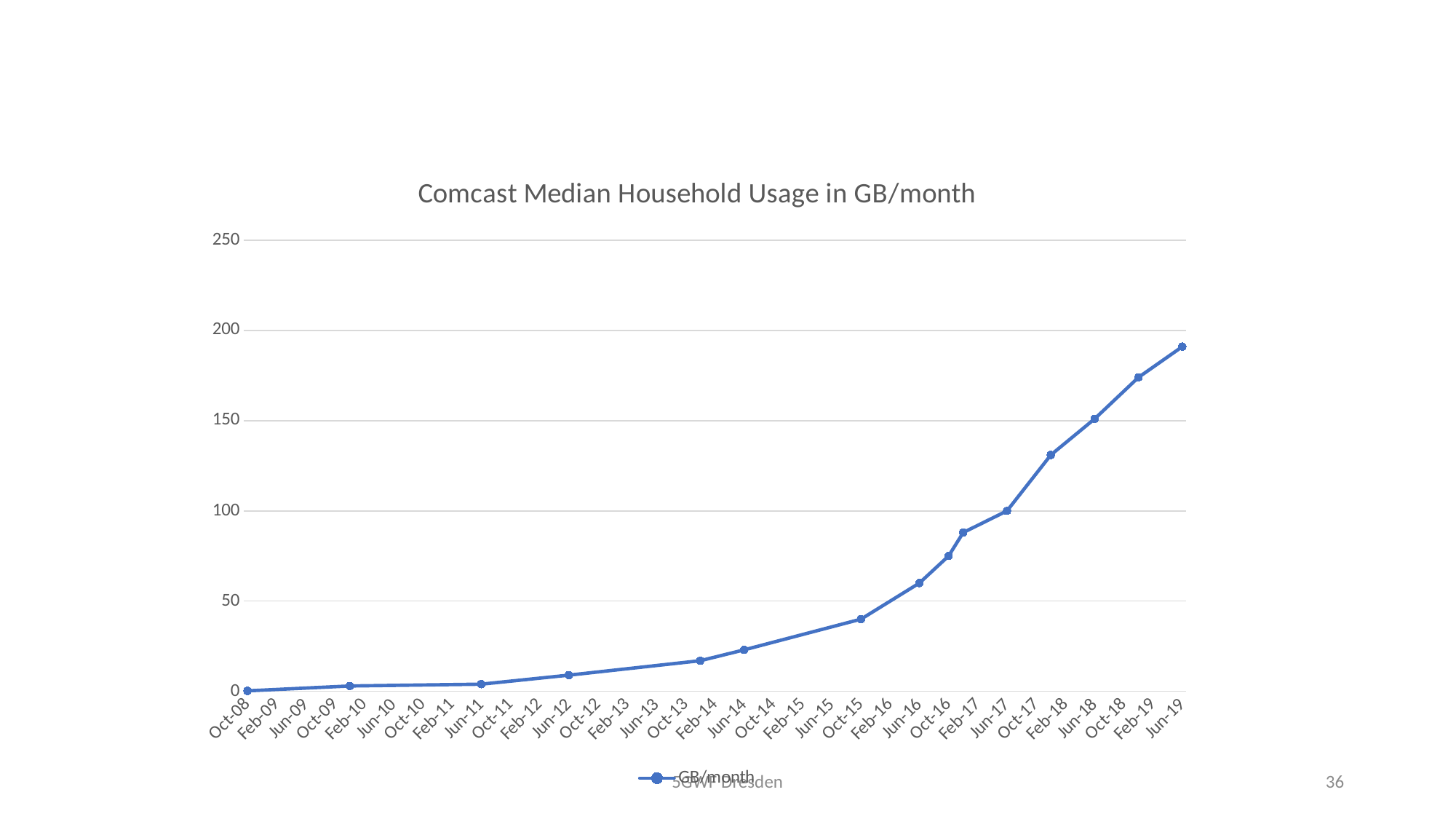
Which is larger, the value for Feb-19 or the value for Jun-18? Feb-19 What is the name of the series shown in the legend? GB/month Do the values rise or fall from Oct-08 to Jun-19? rise At which date is the plotted value lowest? Oct-08 What is the title of the chart? Comcast Median Household Usage in GB/month Is the value for Feb-18 greater or less than 150? less How many series does the legend list? 1 Is the value for Oct-15 greater or less than 50? less At which date is the plotted value highest? Jun-19 What kind of chart is shown on the slide? line chart Is the value for Jun-19 greater or less than 150? greater How many data points are plotted on the line? 15